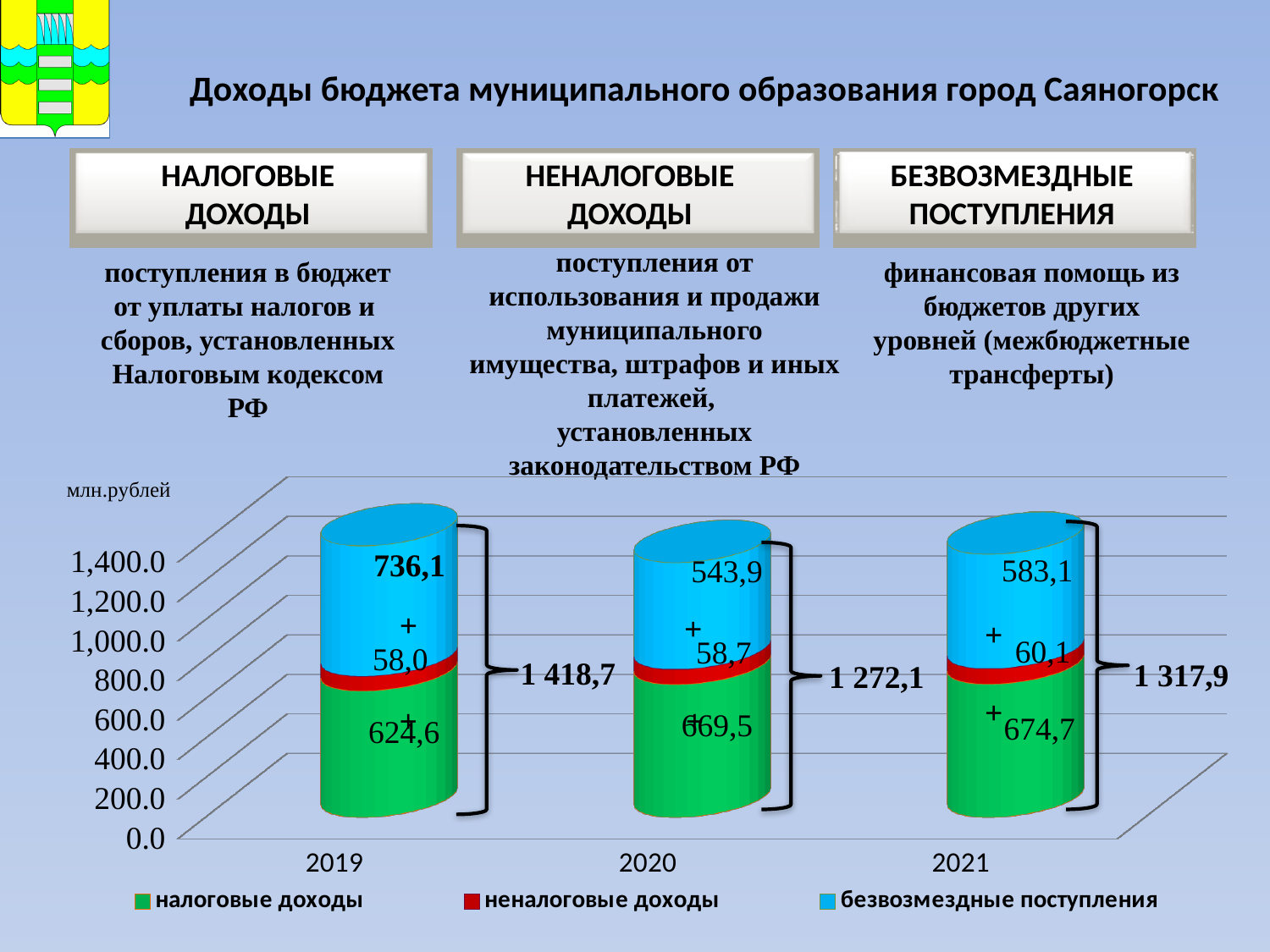
What is the value of неналоговые доходы for 2020? 58,7 What type of chart is shown on the slide? bar chart What is the difference between the total for 2019 and the total for 2021? 100,8 What is the value of безвозмездные поступления for 2019? 736,1 What is the value of налоговые доходы for 2021? 674,7 Which year has the lowest value for безвозмездные поступления? 2020 How many series does the chart legend list? 3 What is the total of the stacked bar for 2020? 1 272,1 Which is larger: налоговые доходы in 2019 or налоговые доходы in 2020? 2020 How many years are shown on the x axis of the chart? 3 What unit is indicated for the values on the chart? млн.рублей Which year has the highest total budget income? 2019